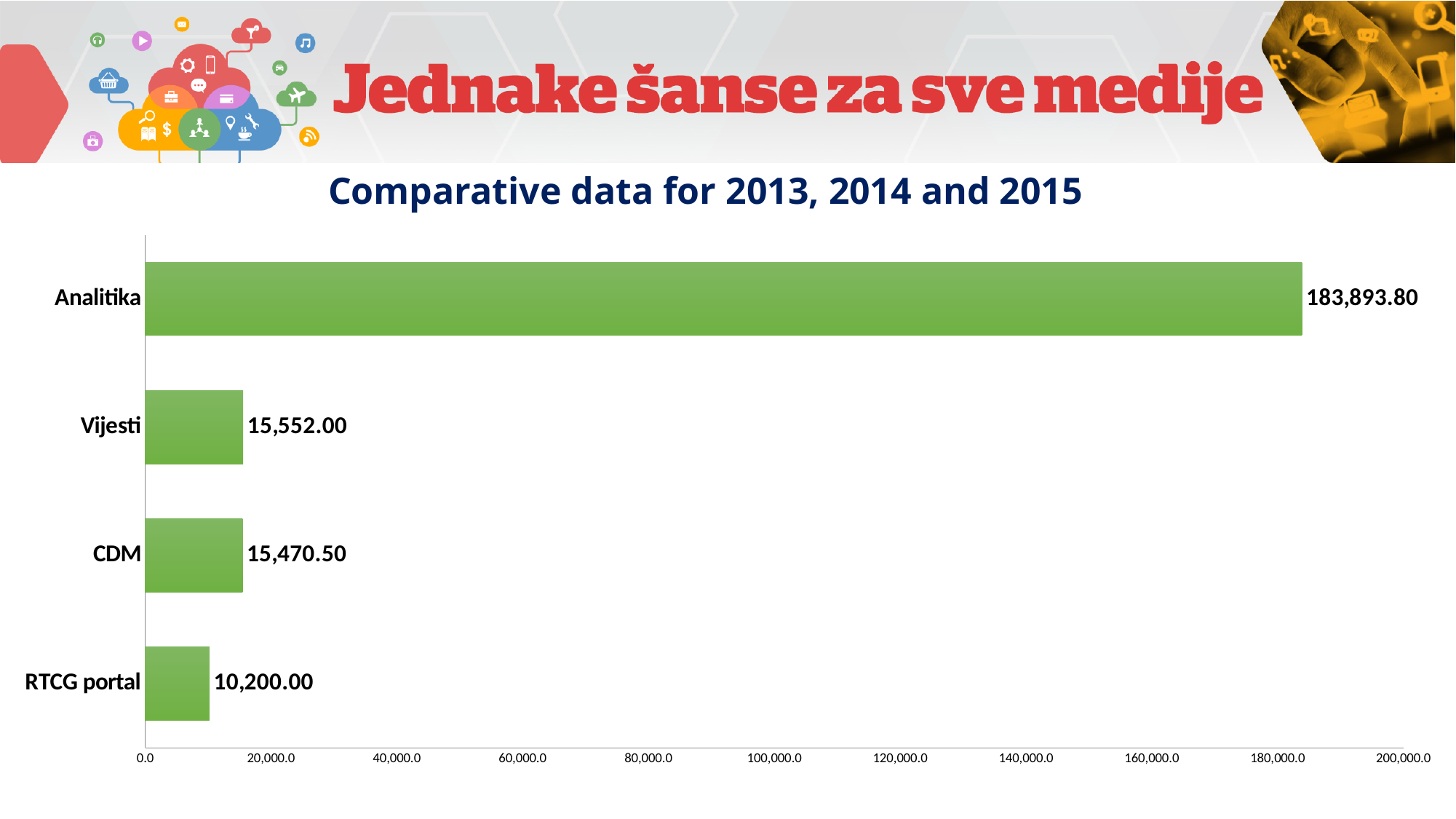
What is the value for Analitika? 183,893.80 What is the difference between the values for Vijesti and CDM? 81.50 What is the value for RTCG portal? 10,200.00 Is the value for Analitika greater or less than 160,000.0? greater What is the value for Vijesti? 15,552.00 Which is larger, the value for Analitika or the value for Vijesti? Analitika What type of chart is shown on the slide? Bar chart Which category has the lowest value? RTCG portal How many categories are shown in the chart? 4 What is the value for CDM? 15,470.50 Which category has the highest value? Analitika What is the difference between the values for Analitika and RTCG portal? 173,693.80